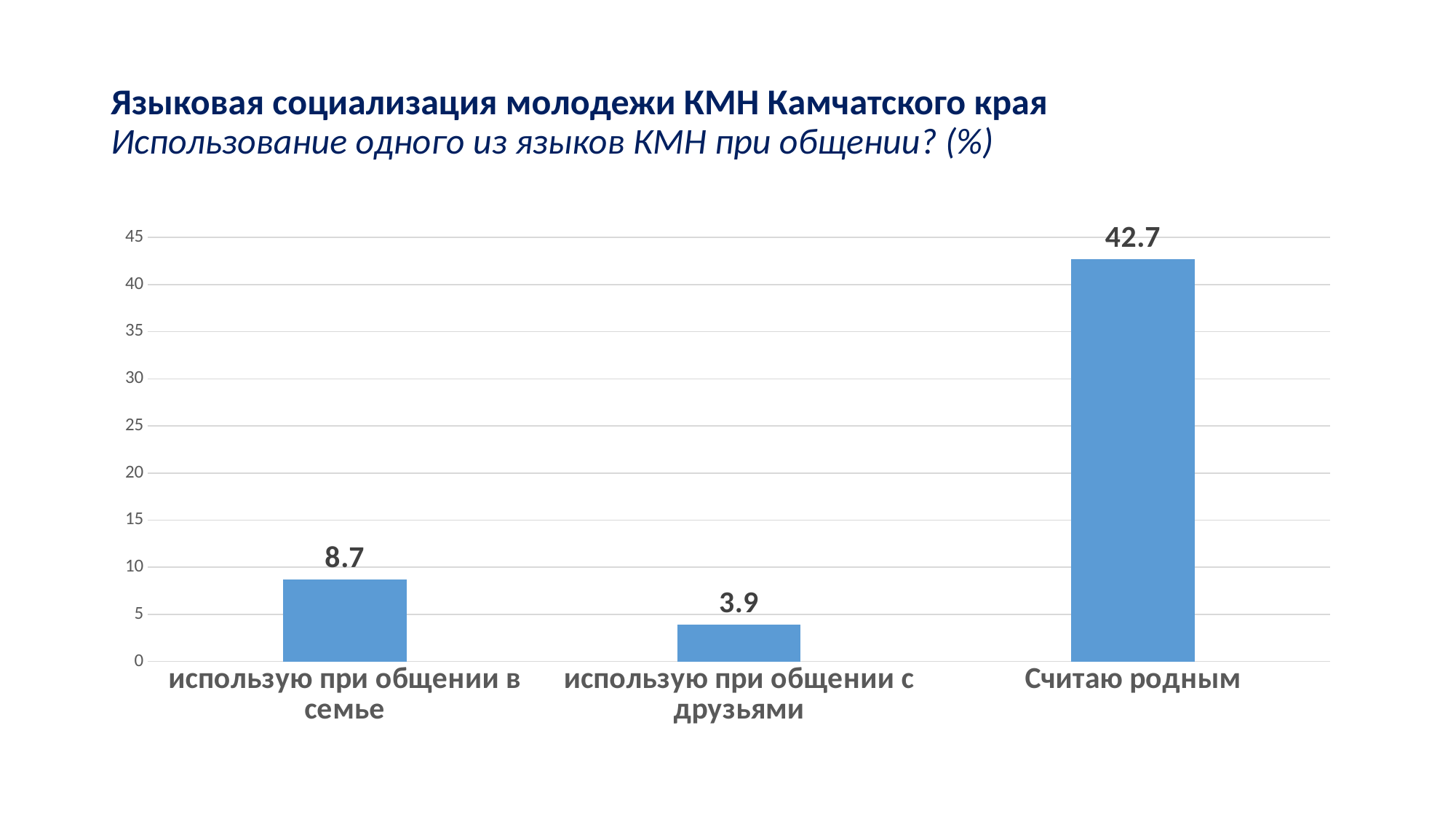
Which category has the highest value? Считаю родным Which is larger: the value for "использую при общении в семье" or for "использую при общении с друзьями"? использую при общении в семье What is the difference between the values for "Считаю родным" and "использую при общении в семье"? 34 Which category has the lowest value? использую при общении с друзьями What kind of chart is shown on the slide? bar chart How many categories are shown on the chart? 3 What is the value for "использую при общении с друзьями"? 3.9 What is the value for "Считаю родным"? 42.7 What is the maximum value shown on the vertical axis? 45 What is the difference between the values for "использую при общении в семье" and "использую при общении с друзьями"? 4.8 Is the value for "Считаю родным" greater or less than 40? greater What is the value for "использую при общении в семье"? 8.7